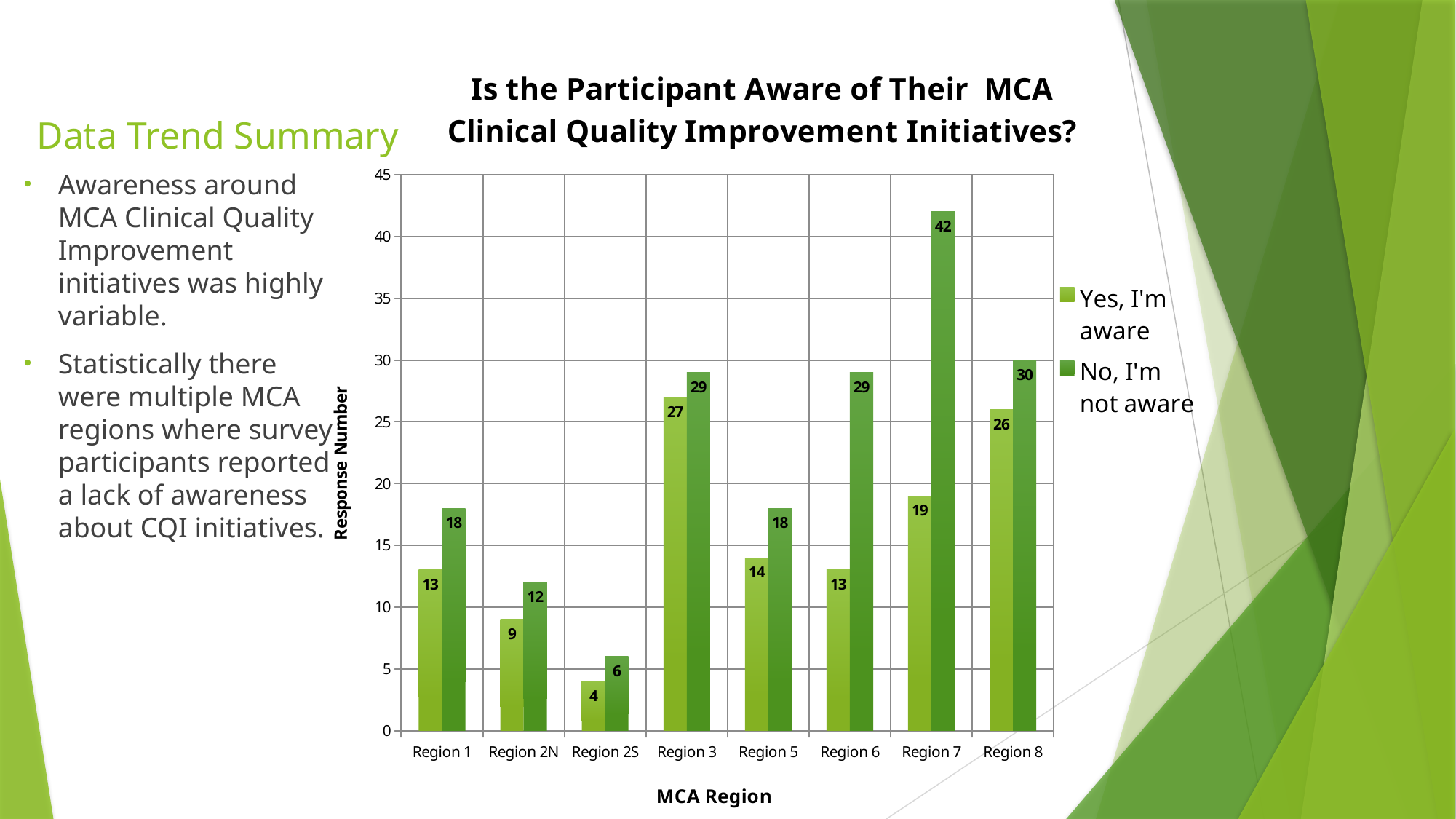
What is the value for "Yes, I'm aware" in Region 2S? 4 What is the difference between the "No, I'm not aware" and "Yes, I'm aware" values in Region 7? 23 What kind of chart is shown? Bar chart How many regions are shown on the x axis? 8 What is the title of the chart? Is the Participant Aware of Their MCA Clinical Quality Improvement Initiatives? What is the value for "No, I'm not aware" in Region 7? 42 What is the value for "Yes, I'm aware" in Region 3? 27 Which region has the lowest "Yes, I'm aware" value? Region 2S Which is larger in Region 6: "Yes, I'm aware" or "No, I'm not aware"? No, I'm not aware What is the label of the y axis? Response Number How many series does the legend list? 2 Which region has the highest "No, I'm not aware" value? Region 7